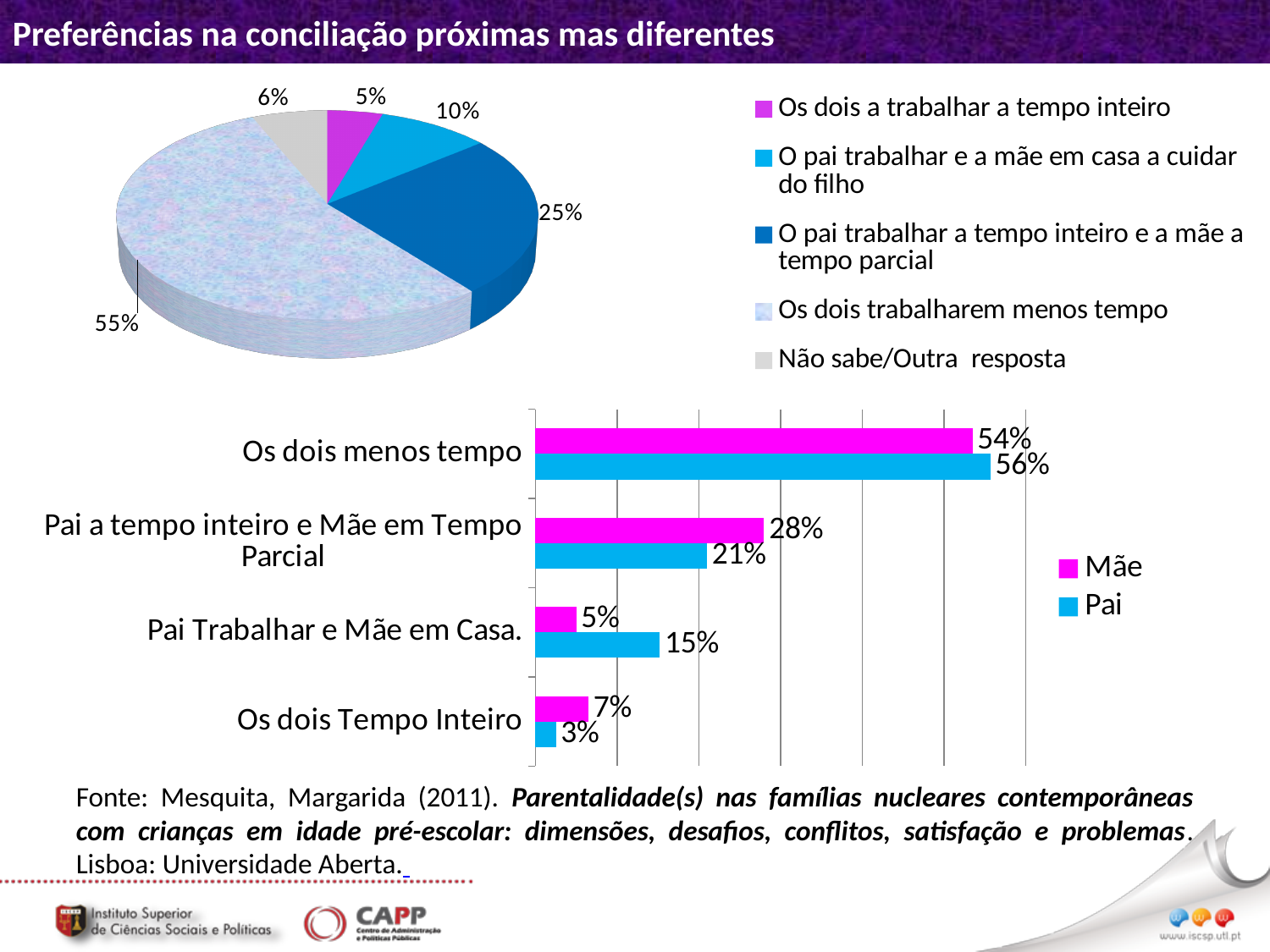
In the pie chart at the top of the slide, what share is labelled for 'O pai trabalhar a tempo inteiro e a mãe a tempo parcial'? 25% How many slices does the pie chart at the top of the slide have? 5 In the bar chart at the bottom of the slide, what is the value for 'Mãe' for 'Pai a tempo inteiro e Mãe em Tempo Parcial'? 28% In the bar chart at the bottom of the slide, what is the difference between the 'Pai' and 'Mãe' values for 'Pai Trabalhar e Mãe em Casa.'? 10% What kind of chart is the chart at the bottom of the slide? Bar chart In the bar chart at the bottom of the slide, what is the value for 'Pai' for 'Os dois menos tempo'? 56% How many series does the legend of the bar chart at the bottom of the slide list? 2 In the pie chart at the top of the slide, which category has the smallest slice? Os dois a trabalhar a tempo inteiro In the bar chart at the bottom of the slide, what colour are the 'Mãe' bars? Magenta In the bar chart at the bottom of the slide, which is larger for 'Os dois Tempo Inteiro': the 'Mãe' value or the 'Pai' value? Mãe In the bar chart at the bottom of the slide, which category has the highest 'Mãe' value? Os dois menos tempo In the pie chart at the top of the slide, what share is labelled for 'Os dois trabalharem menos tempo'? 55%